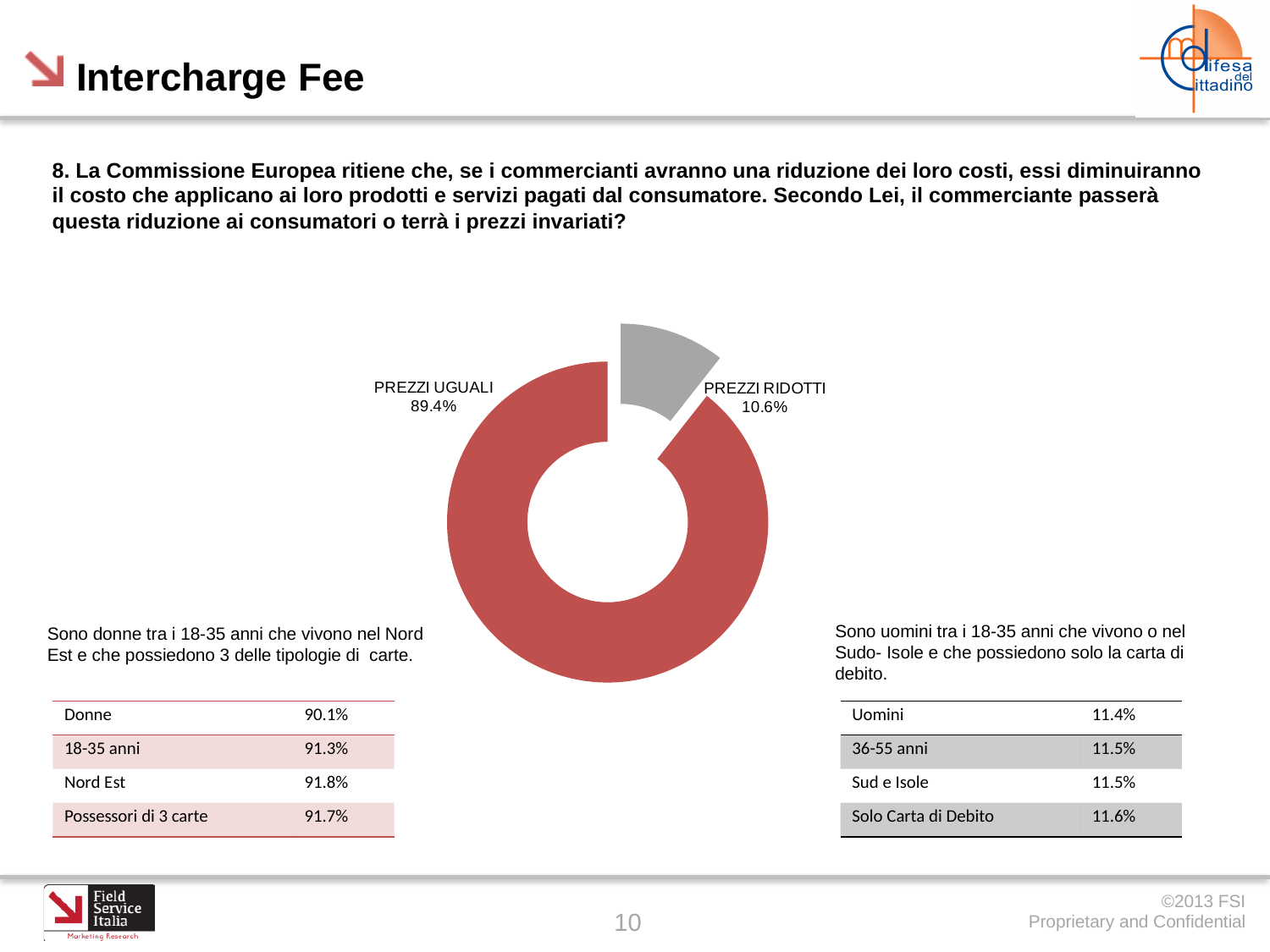
What colour is the PREZZI RIDOTTI slice? Grey How many categories are shown in the doughnut chart? 2 Which is larger, PREZZI UGUALI or PREZZI RIDOTTI? PREZZI UGUALI What colour is the PREZZI UGUALI slice? Red What is the total of the two slices in the doughnut chart? 100% What is the value for PREZZI UGUALI? 89.4% Which category has the smallest share of the doughnut chart? PREZZI RIDOTTI What share of the doughnut chart does PREZZI RIDOTTI represent? 10.6% What is the difference between the PREZZI UGUALI and PREZZI RIDOTTI values? 78.8% What is the value for PREZZI RIDOTTI? 10.6% What kind of chart is shown on the slide? Doughnut chart Which category has the largest share of the doughnut chart? PREZZI UGUALI